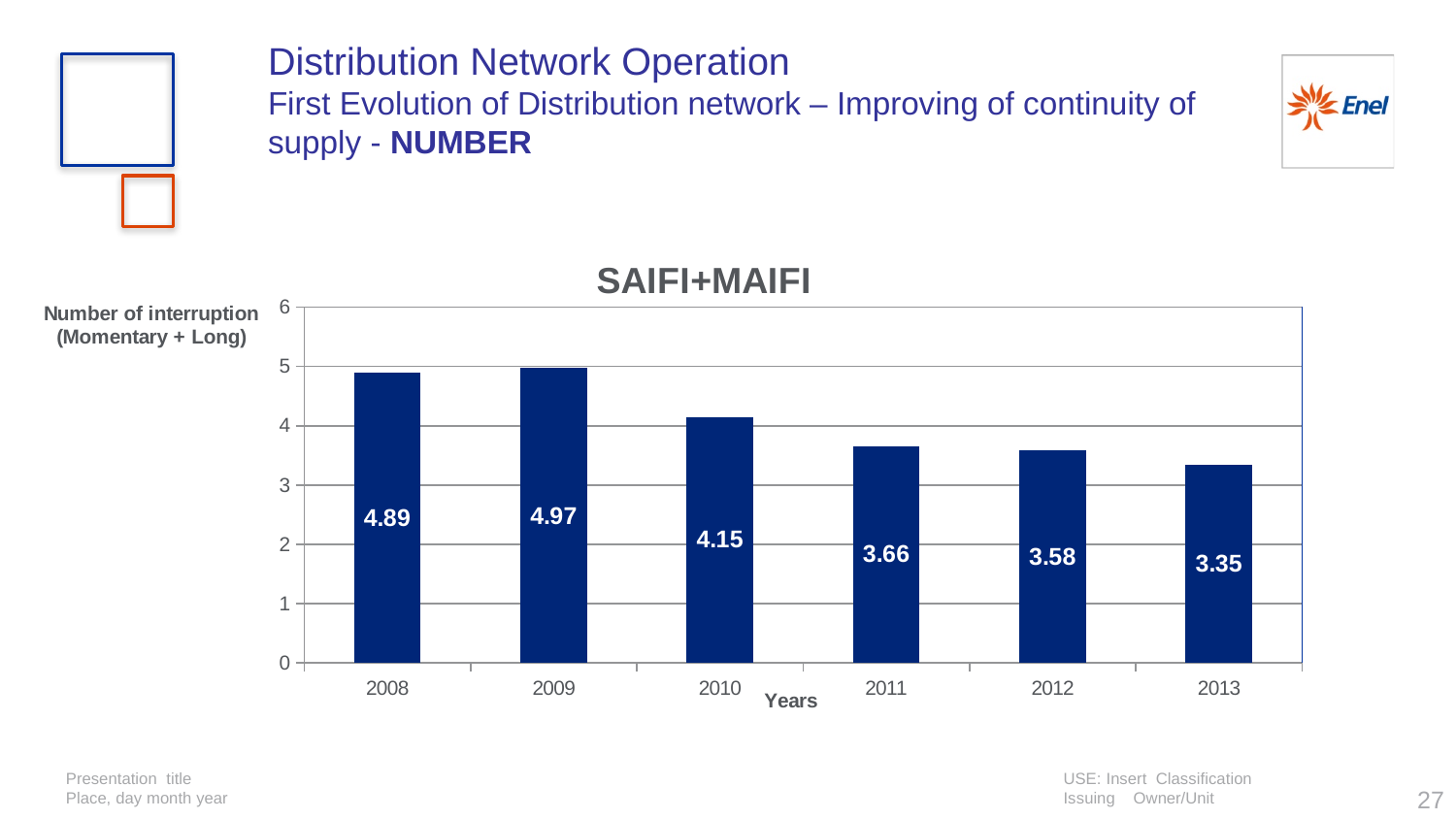
Is the value for 2012 in the SAIFI+MAIFI chart greater or less than 4? less What is the label of the x axis in the SAIFI+MAIFI chart? Years Which is larger in the SAIFI+MAIFI chart, the value for 2008 or the value for 2010? 2008 What is the difference between the 2009 and 2013 values in the SAIFI+MAIFI chart? 1.62 Which year has the lowest value in the SAIFI+MAIFI chart? 2013 What is the value for 2011 in the SAIFI+MAIFI chart? 3.66 What kind of chart is the SAIFI+MAIFI chart? bar chart What is the value for 2013 in the SAIFI+MAIFI chart? 3.35 What is the difference between the 2010 and 2011 values in the SAIFI+MAIFI chart? 0.49 How many years are shown on the x axis of the SAIFI+MAIFI chart? 6 What is the value for 2008 in the SAIFI+MAIFI chart? 4.89 Which year has the highest value in the SAIFI+MAIFI chart? 2009